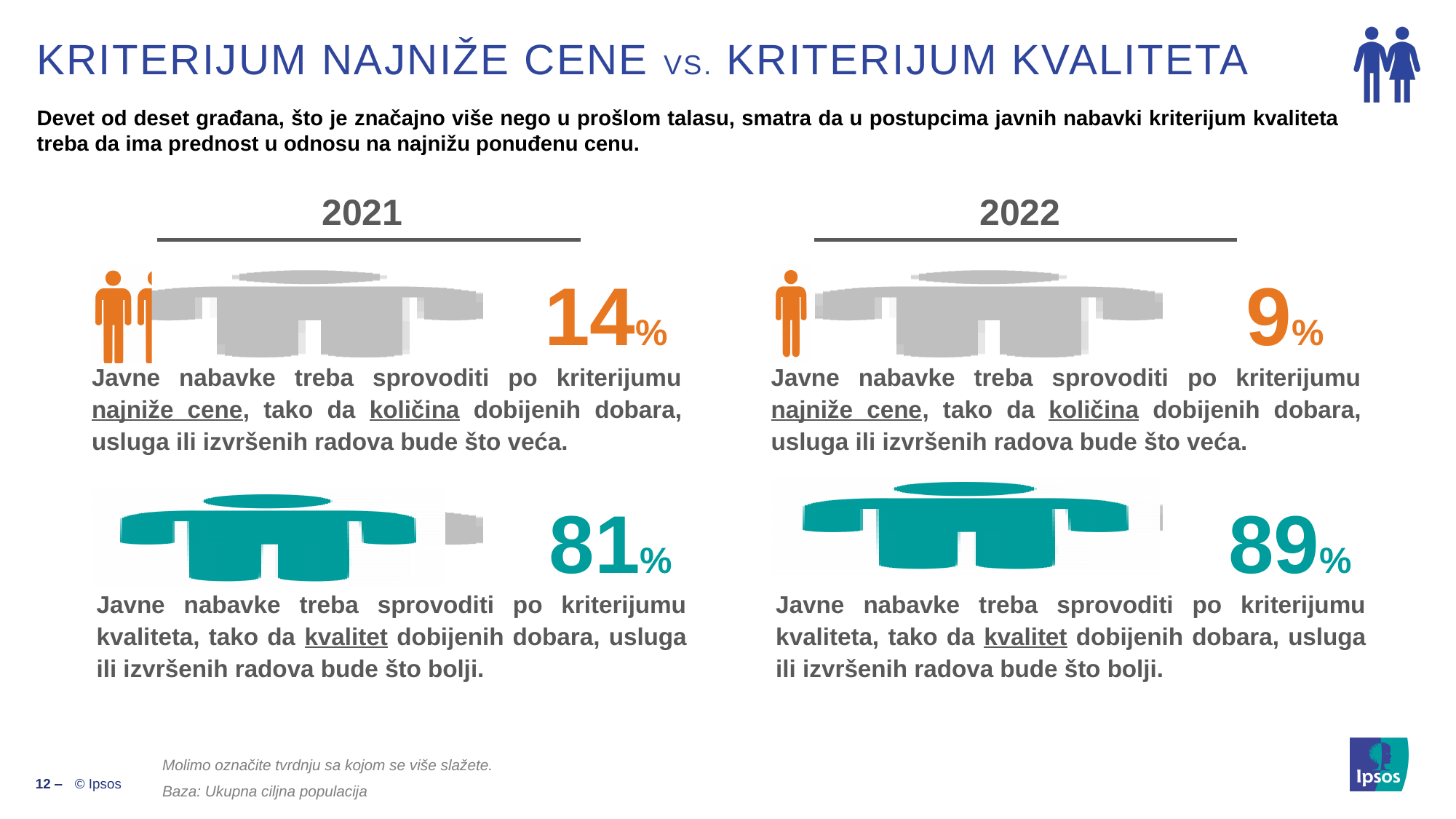
In the 2021 chart, what percentage of citizens think public procurement should follow the quality criterion? 81% In the 2021 chart, what percentage of citizens think public procurement should follow the lowest price criterion? 14% In the 2022 chart, what percentage of citizens think public procurement should follow the quality criterion? 89% In the 2022 chart, what percentage of citizens think public procurement should follow the lowest price criterion? 9% What colour represents the quality criterion in the charts? Teal What is the difference between the quality criterion percentage in 2022 and in 2021? 8 percentage points Across both charts, which year and criterion has the lowest percentage? 2022, lowest price criterion (9%) What is the difference between the lowest price criterion percentage in 2021 and in 2022? 5 percentage points Across both charts, which year and criterion has the highest percentage? 2022, quality criterion (89%) Which is larger: the quality criterion percentage in 2021 or in 2022? 2022 Did the share of citizens preferring the lowest price criterion rise or fall from 2021 to 2022? Fall What kind of chart is used to show the percentages on this slide? Pictograph (people icons)